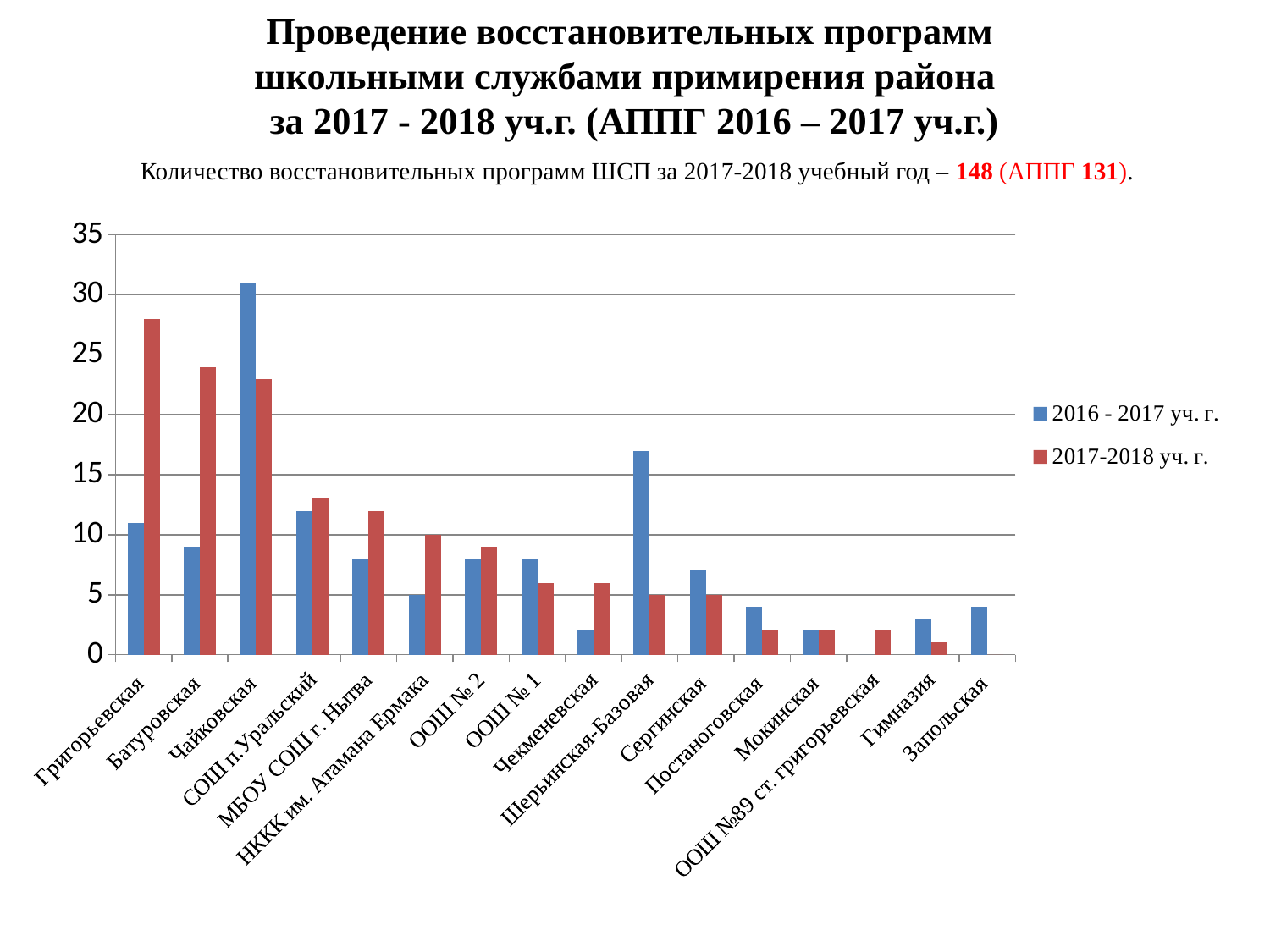
Is the value for Чайковская in 2016 - 2017 уч. г. greater or less than 25? greater How many school categories are shown on the x axis? 16 What colour are the bars for the 2017-2018 уч. г. series? red Is the value for Шерьинская-Базовая in 2016 - 2017 уч. г. greater or less than 15? greater How many series does the legend list? 2 Is the value for Григорьевская in 2017-2018 уч. г. greater or less than 25? greater Which school has the highest value for the 2016 - 2017 уч. г. series? Чайковская What kind of chart is shown on the slide? bar chart For Чайковская, which series has the larger value: 2016 - 2017 уч. г. or 2017-2018 уч. г.? 2016 - 2017 уч. г. For Григорьевская, which series has the larger value: 2016 - 2017 уч. г. or 2017-2018 уч. г.? 2017-2018 уч. г. Which school has the highest value for the 2017-2018 уч. г. series? Григорьевская